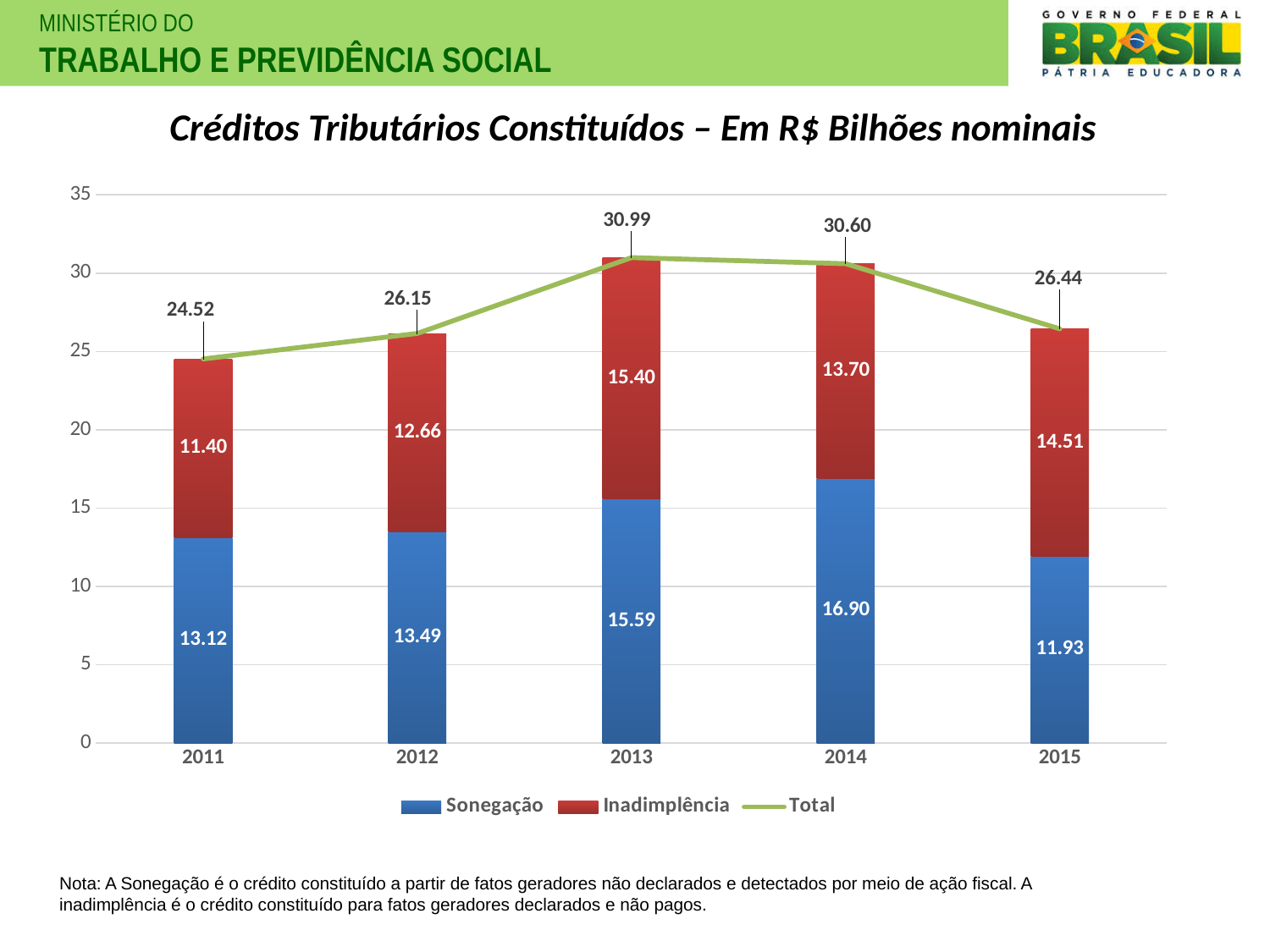
How many series does the legend list? 3 What is the Inadimplência value for 2012? 12.66 Which year has the lowest Sonegação value? 2015 What is the Sonegação value for 2014? 16.90 Does the Total rise or fall from 2011 to 2013? Rise What is the title of the chart? Créditos Tributários Constituídos – Em R$ Bilhões nominais What is the difference between the Sonegação values for 2014 and 2015? 4.97 Which year has the highest Total? 2013 What is the Total value for 2013? 30.99 Which is larger in 2015, Sonegação or Inadimplência? Inadimplência What kind of chart is shown on the slide? Stacked bar chart with a line How many years are shown on the x axis? 5